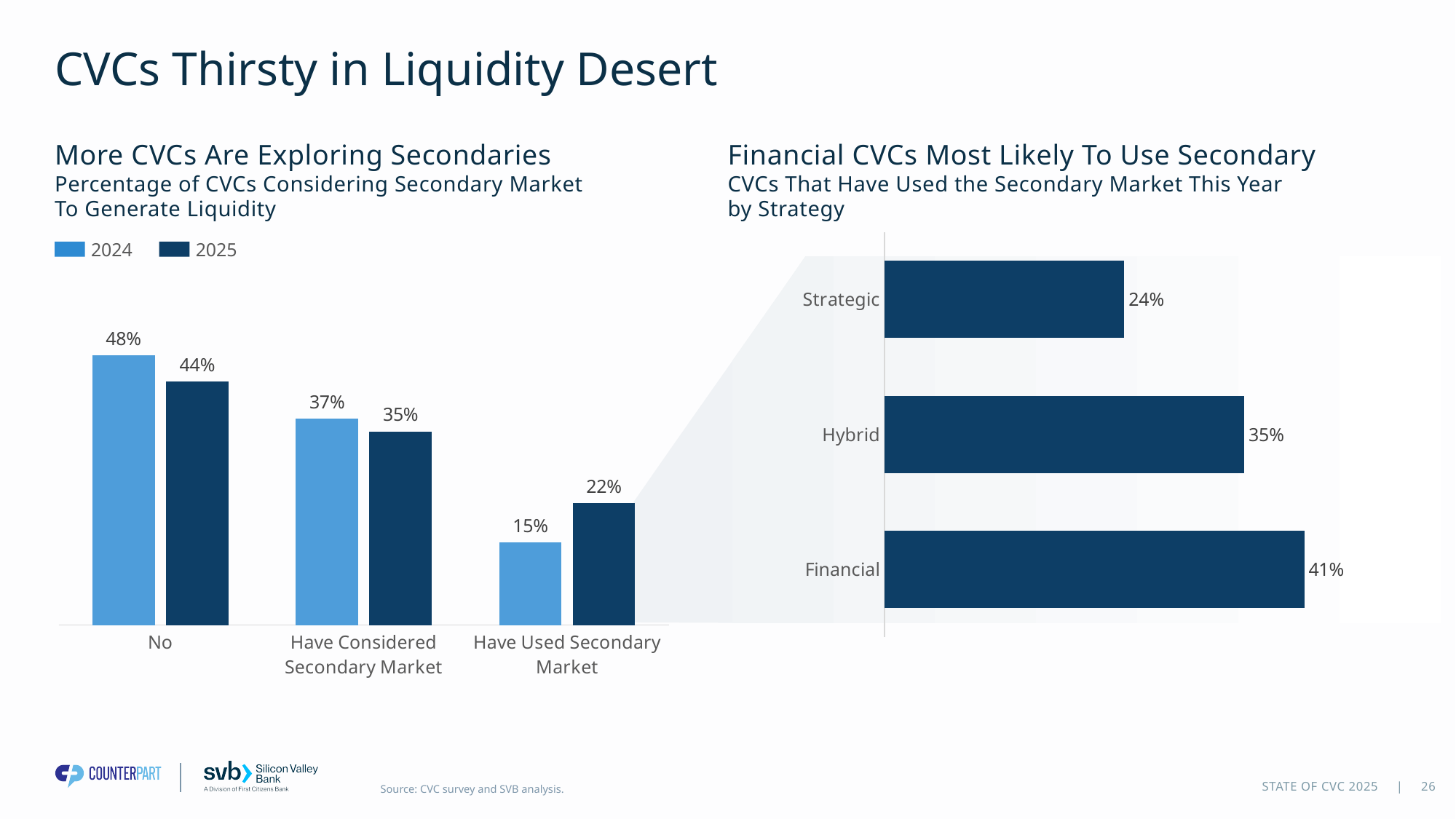
In the 'Financial CVCs Most Likely To Use Secondary' chart, which strategy has the highest value? Financial How many categories are shown on the x axis of the 'More CVCs Are Exploring Secondaries' chart? 3 In the 'Financial CVCs Most Likely To Use Secondary' chart, what is the value for Hybrid? 35% In the 'More CVCs Are Exploring Secondaries' chart, what is the 2024 value for 'No'? 48% How many series does the legend of the 'More CVCs Are Exploring Secondaries' chart list? 2 In the 'More CVCs Are Exploring Secondaries' chart, which colour represents 2025? Dark blue In the 'More CVCs Are Exploring Secondaries' chart, what is the 2025 value for 'Have Used Secondary Market'? 22% In the 'Financial CVCs Most Likely To Use Secondary' chart, what is the difference between the Financial and Strategic values? 17% In the 'More CVCs Are Exploring Secondaries' chart, what is the difference between the 2024 and 2025 values for 'No'? 4% In the 'More CVCs Are Exploring Secondaries' chart, which category has the lowest 2024 value? Have Used Secondary Market What kind of chart is the 'Financial CVCs Most Likely To Use Secondary' chart? Bar chart In the 'More CVCs Are Exploring Secondaries' chart, which is larger for 'Have Considered Secondary Market': the 2024 value or the 2025 value? 2024